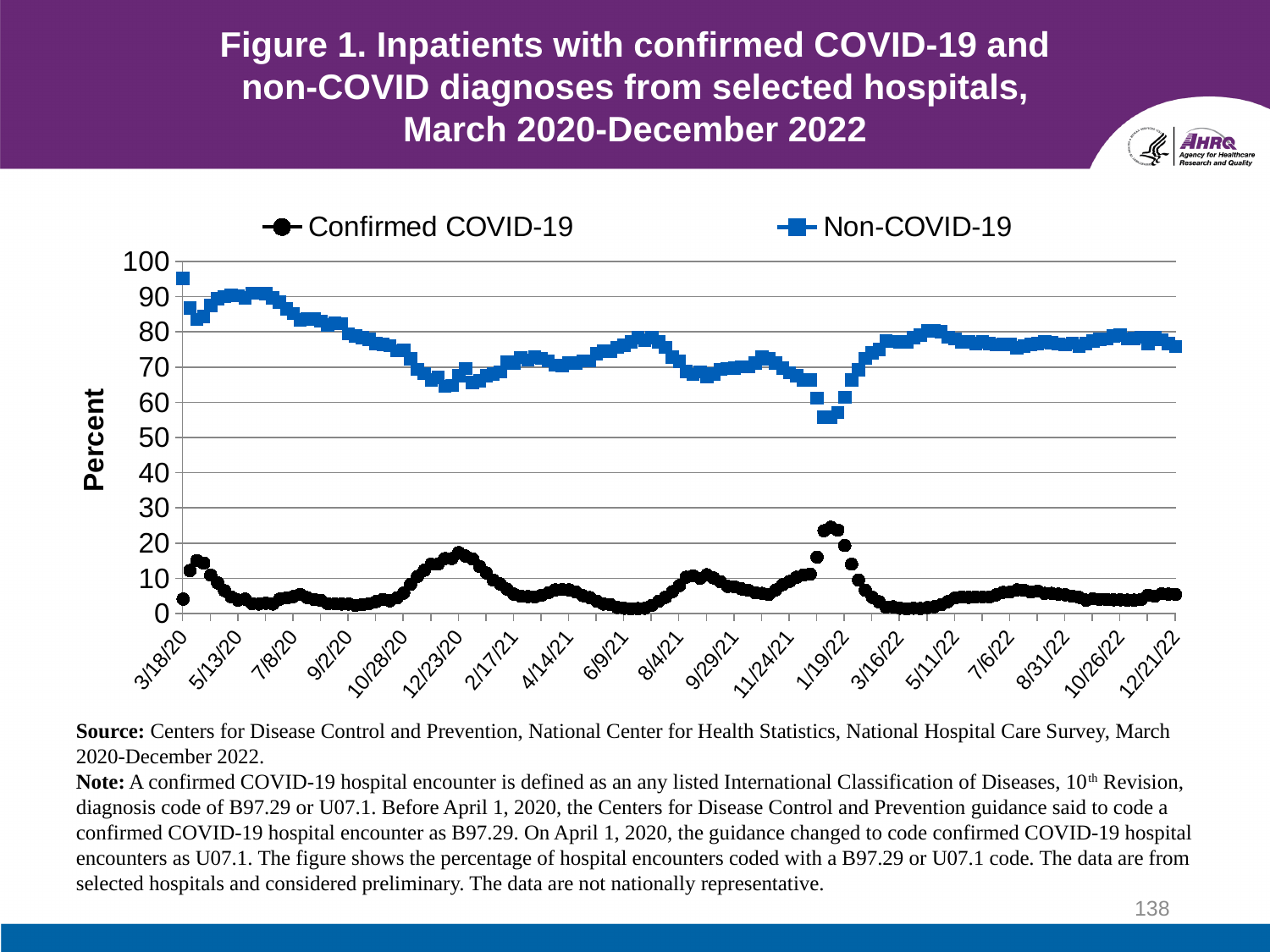
What kind of chart is shown on the slide? Line chart Is the value for Confirmed COVID-19 at 3/18/20 greater or less than 10? less Around which x-axis date does the Non-COVID-19 series reach its lowest point? 1/19/22 Which series has the higher value at 7/8/20, Confirmed COVID-19 or Non-COVID-19? Non-COVID-19 Does the Non-COVID-19 series rise or fall between 5/13/20 and 12/23/20? fall How many series does the legend list? 2 Which series is plotted with blue square markers? Non-COVID-19 Around which x-axis date does the Confirmed COVID-19 series reach its highest point? 1/19/22 What is the label on the vertical axis? Percent Is the value for Non-COVID-19 at 1/19/22 greater or less than 70? less Is the value for Non-COVID-19 at 3/18/20 greater or less than 90? greater